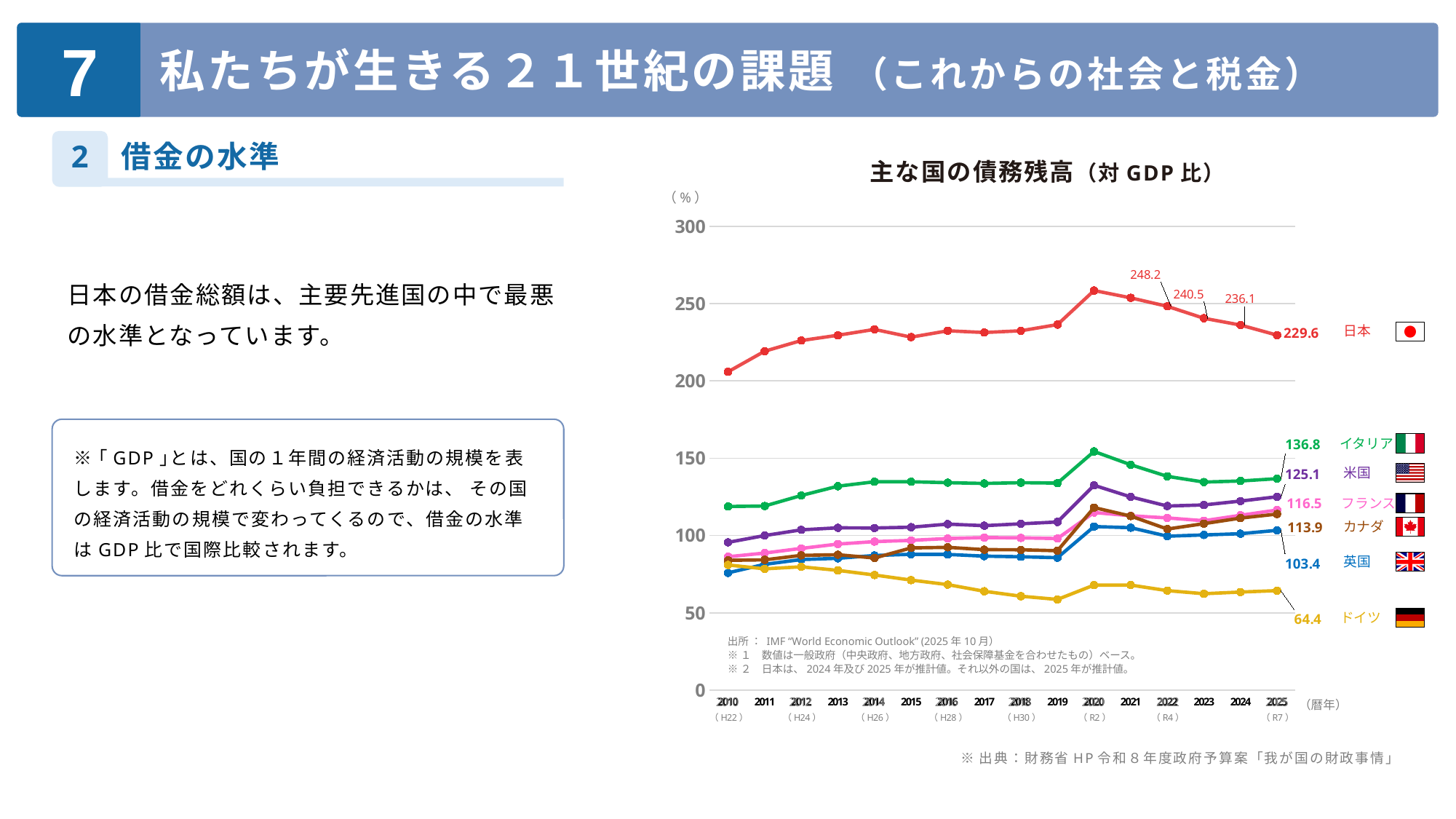
What is the value for 日本 in 2025? 229.6 What is the value for 日本 in 2022? 248.2 How many countries are plotted on the chart? 7 What is the value for ドイツ in 2025? 64.4 Is the value for 日本 in 2010 greater or less than 200? greater What is the difference between the 2025 values for 日本 and イタリア? 92.8 What is the value for イタリア in 2025? 136.8 What is the difference between the 2022 and 2025 values for 日本? 18.6 Which country has the highest value in 2025? 日本 What kind of chart is shown on the slide? line chart Which country has the lowest value in 2025? ドイツ Which is larger in 2025, the value for 米国 or the value for フランス? 米国